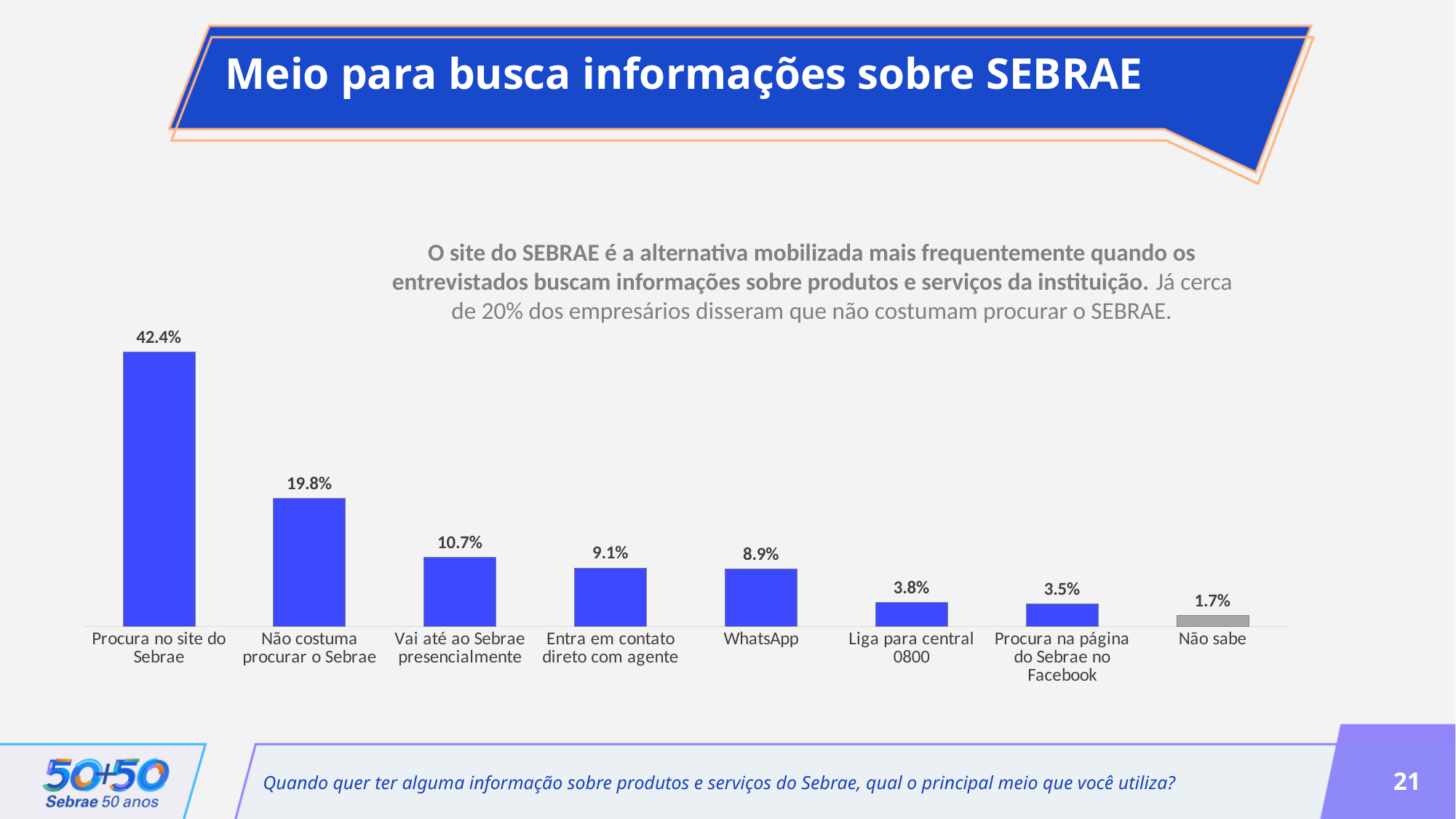
What is the difference between "Vai até ao Sebrae presencialmente" and "Entra em contato direto com agente"? 1.6% What is the difference between "Procura no site do Sebrae" and "Não costuma procurar o Sebrae"? 22.6% What is the value for "WhatsApp"? 8.9% Which is larger: "Não costuma procurar o Sebrae" or "Vai até ao Sebrae presencialmente"? Não costuma procurar o Sebrae What is the value for "Liga para central 0800"? 3.8% Which category has the highest value? Procura no site do Sebrae Which bar is coloured grey instead of blue? Não sabe Which category has the lowest value? Não sabe What is the value for "Não sabe"? 1.7% What kind of chart is shown on the slide? Bar chart What is the value for "Procura no site do Sebrae"? 42.4% How many categories are shown in the chart? 8